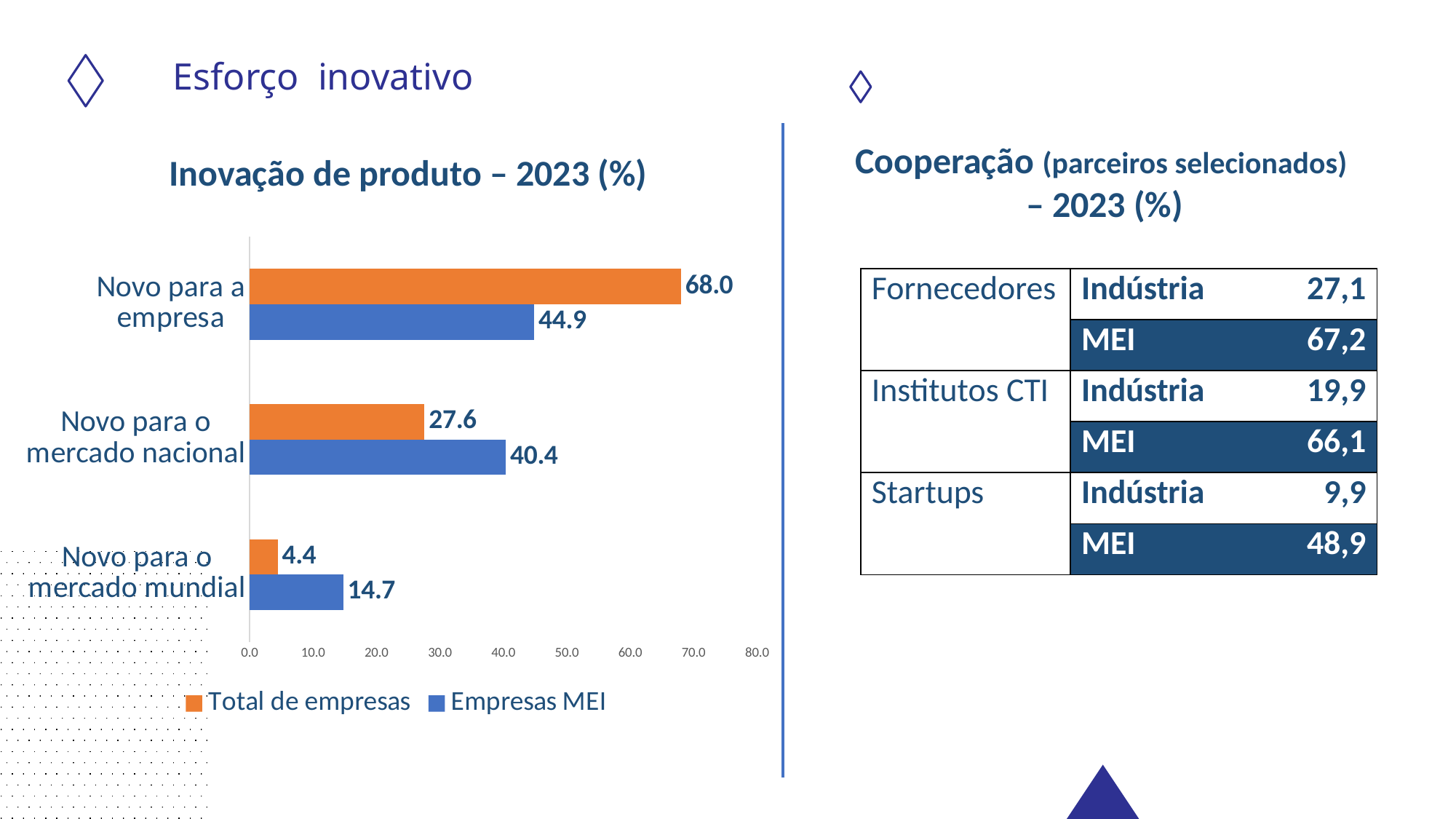
What kind of chart is shown on the slide? bar chart What is the title of the chart? Inovação de produto – 2023 (%) Is the value for 'Empresas MEI' in 'Novo para o mercado mundial' greater or less than 20.0? less In the 'Novo para o mercado nacional' category, which series has the larger value, 'Total de empresas' or 'Empresas MEI'? Empresas MEI What is the value for 'Total de empresas' in the 'Novo para a empresa' category? 68.0 Which category has the highest value for 'Empresas MEI'? Novo para a empresa How many categories are shown on the chart? 3 What is the difference between 'Total de empresas' and 'Empresas MEI' in the 'Novo para a empresa' category? 23.1 Which category has the lowest value for 'Total de empresas'? Novo para o mercado mundial What is the value for 'Empresas MEI' in the 'Novo para o mercado nacional' category? 40.4 How many series does the legend list? 2 What is the value for 'Total de empresas' in the 'Novo para o mercado mundial' category? 4.4